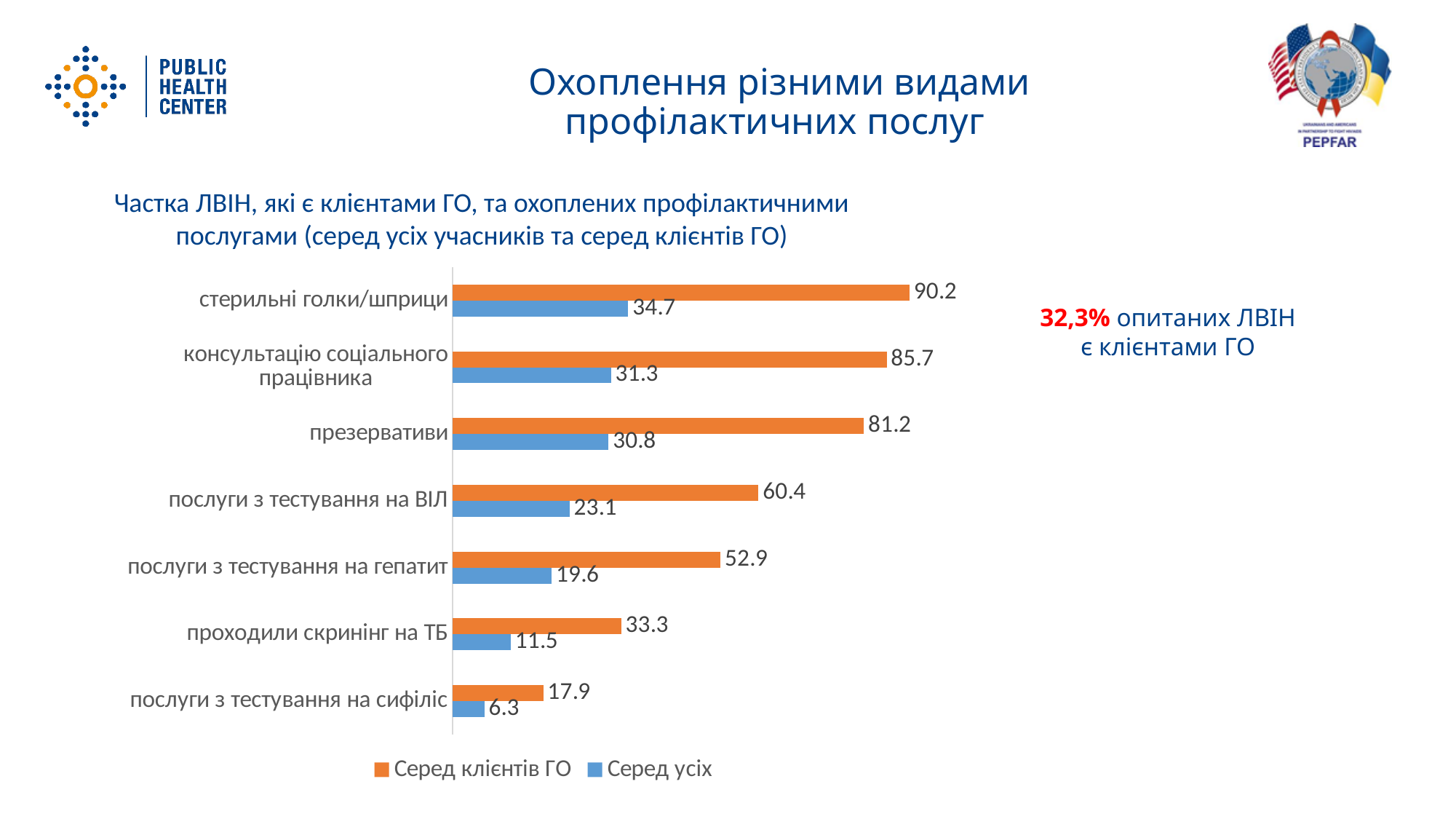
What is the difference between the 'Серед клієнтів ГО' and 'Серед усіх' values for 'презервативи'? 50.4 What is the value for 'проходили скринінг на ТБ' in the 'Серед клієнтів ГО' series? 33.3 How many categories are shown on the chart? 7 Which is larger: the 'Серед усіх' value for 'консультацію соціального працівника' or for 'послуги з тестування на гепатит'? консультацію соціального працівника What is the value for 'послуги з тестування на ВІЛ' in the 'Серед усіх' series? 23.1 Which colour represents the 'Серед усіх' series? blue Which category has the highest value in the 'Серед усіх' series? стерильні голки/шприци How many series does the legend list? 2 What is the 'Серед усіх' value for 'послуги з тестування на сифіліс'? 6.3 What kind of chart is shown on the slide? bar chart What is the value for 'стерильні голки/шприци' in the 'Серед клієнтів ГО' series? 90.2 Which category has the lowest value in the 'Серед клієнтів ГО' series? послуги з тестування на сифіліс